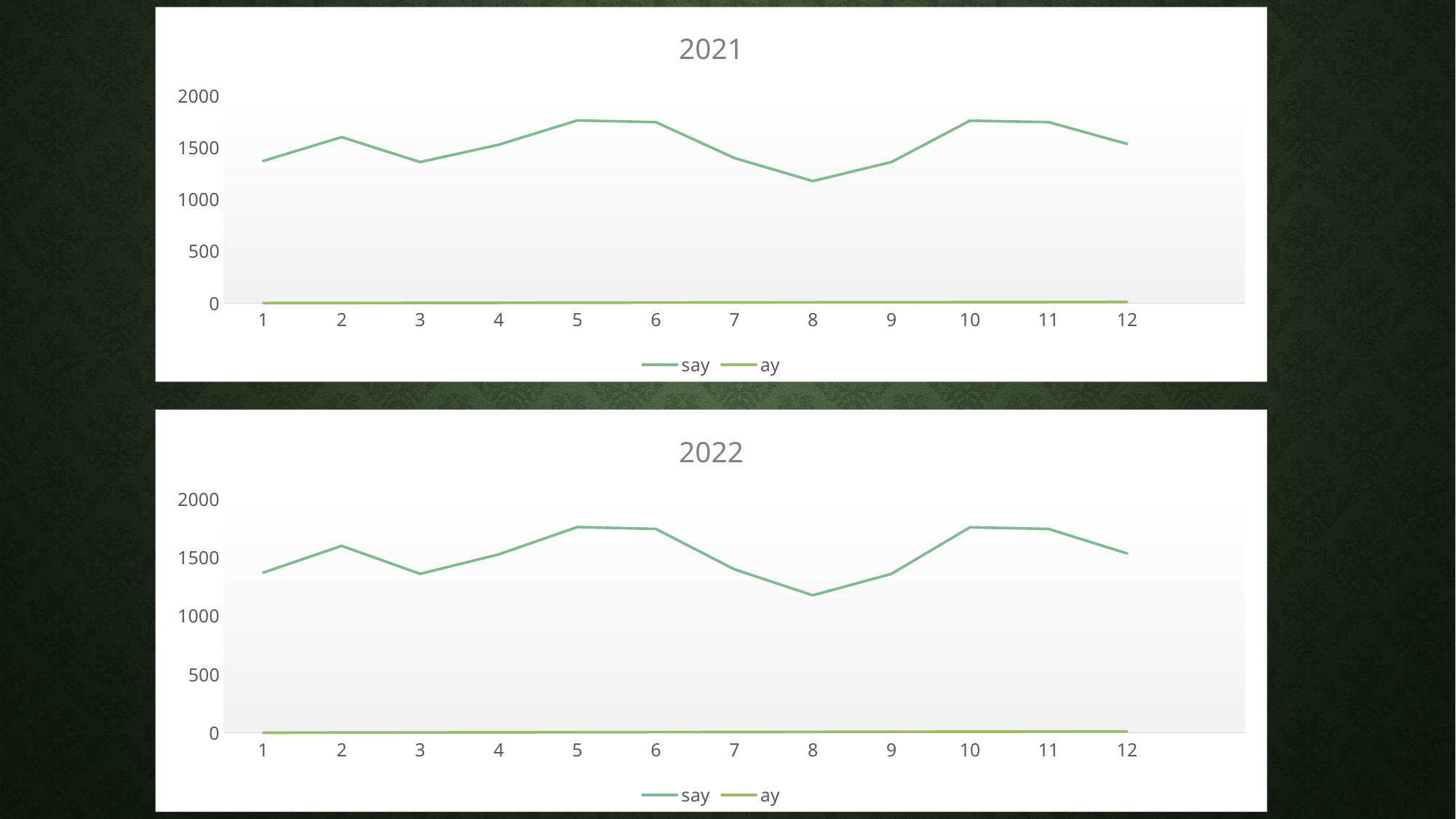
In the chart titled 2021, what kind of chart is shown? line chart In the chart titled 2021, at which x-axis point is the value of the say series lowest? 8 In the chart titled 2022, at which x-axis point is the value of the say series lowest? 8 In the chart titled 2021, which is larger for the say series: the value at point 7 or the value at point 8? point 7 In the chart titled 2022, is the value of the say series at point 5 greater or less than 1500? greater In the chart titled 2021, how many points are plotted along the x axis for each series? 12 In the chart titled 2022, which is larger for the say series: the value at point 2 or the value at point 3? point 2 In the chart titled 2022, how many series does the legend list? 2 In the chart titled 2021, is the value of the say series at point 2 greater or less than 1500? greater In the chart titled 2021, is the value of the say series at point 8 greater or less than 1500? less In the chart titled 2022, does the say series rise or fall from point 5 to point 8? fall In the chart titled 2021, what are the two series names shown in the legend? say and ay